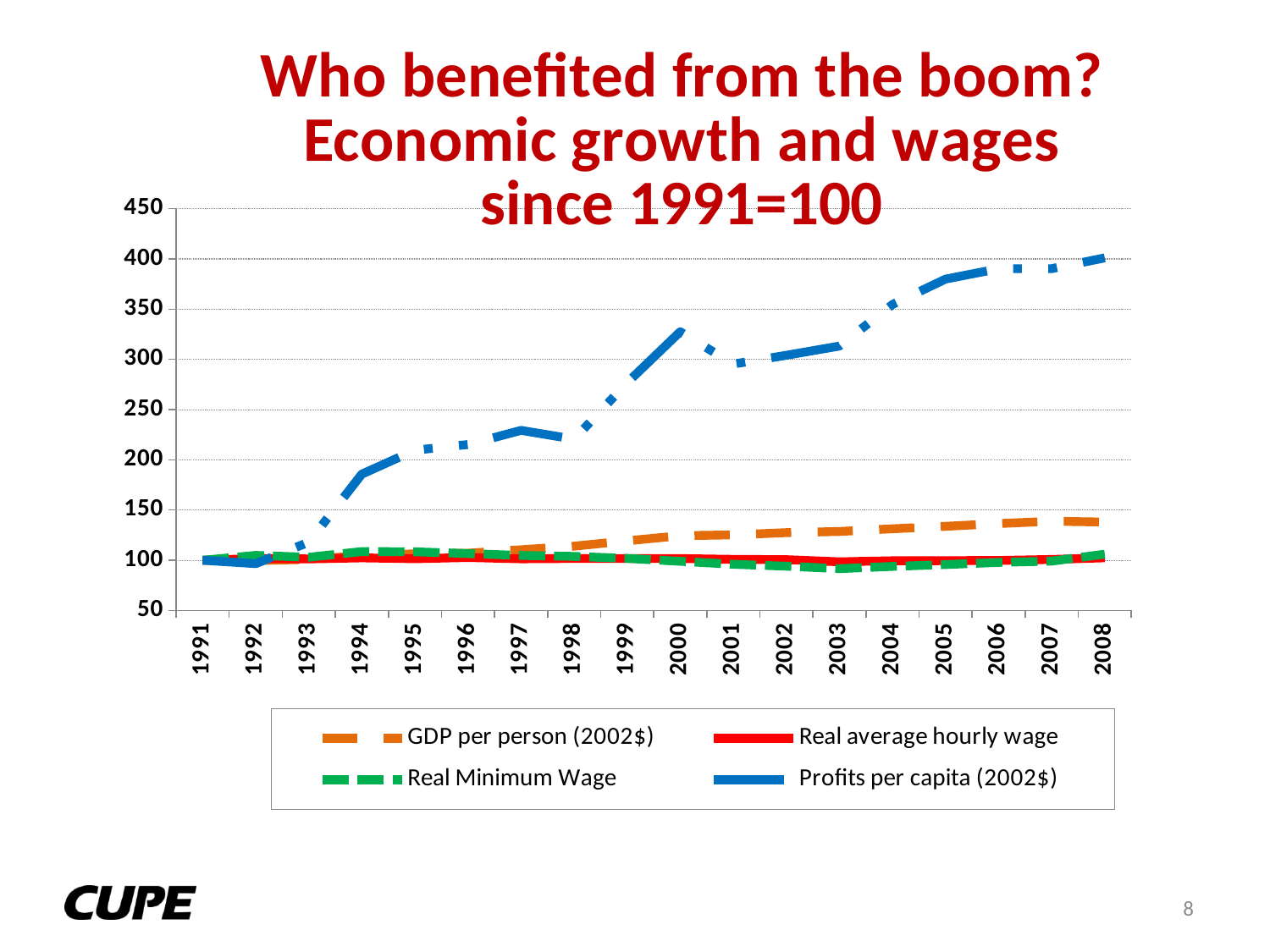
Is the value for GDP per person (2002$) in 2008 greater or less than 150? less Does the Profits per capita (2002$) series generally rise or fall from 1991 to 2008? rise Is the value for Profits per capita (2002$) in 2000 greater or less than 300? greater What is the value of Profits per capita (2002$) in 1991? 100 How many series does the legend list? 4 What kind of chart is shown on the slide? line chart How many years are shown along the x axis? 18 Which series is drawn with a solid red line? Real average hourly wage Is the value for Profits per capita (2002$) in 2008 greater or less than 350? greater Which series has the highest value in 2008? Profits per capita (2002$) In 2008, which is larger: GDP per person (2002$) or Real average hourly wage? GDP per person (2002$)